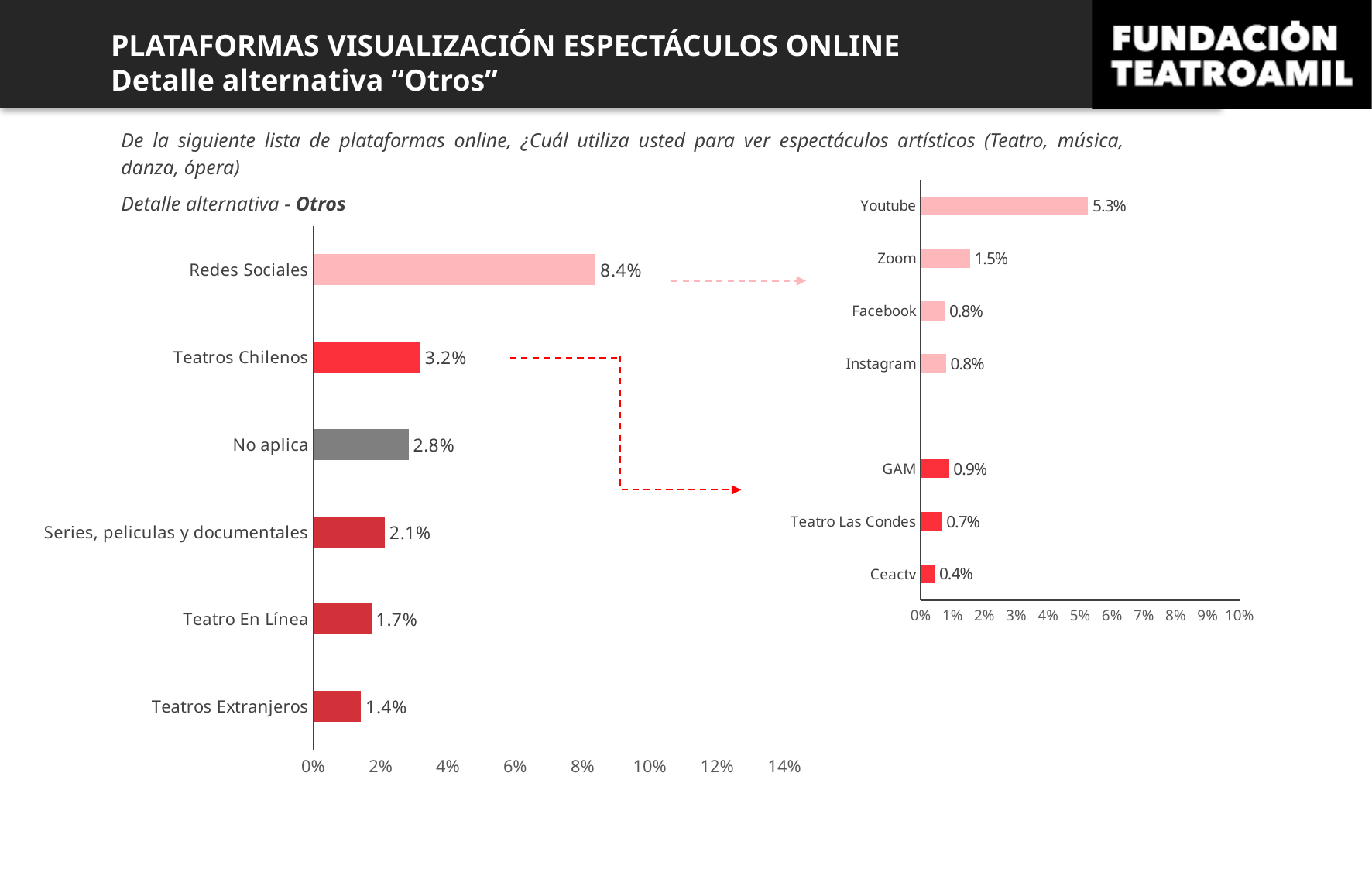
In the left chart (Detalle alternativa - Otros), how many categories are plotted? 6 In the right chart, what is the value for Youtube? 5.3% In the left chart (Detalle alternativa - Otros), what is the difference between Redes Sociales and Teatros Chilenos? 5.2% In the right chart, what is the difference between Zoom and Teatro Las Condes? 0.8% In the left chart (Detalle alternativa - Otros), which is larger: No aplica or Series, peliculas y documentales? No aplica In the left chart (Detalle alternativa - Otros), what is the value for Redes Sociales? 8.4% In the right chart, which category has the highest value? Youtube In the right chart, what is the value for GAM? 0.9% What kind of chart is the left chart (Detalle alternativa - Otros)? Bar chart In the right chart, which category has the lowest value? Ceactv In the left chart (Detalle alternativa - Otros), which category has the lowest value? Teatros Extranjeros In the left chart (Detalle alternativa - Otros), what is the value for Teatros Chilenos? 3.2%